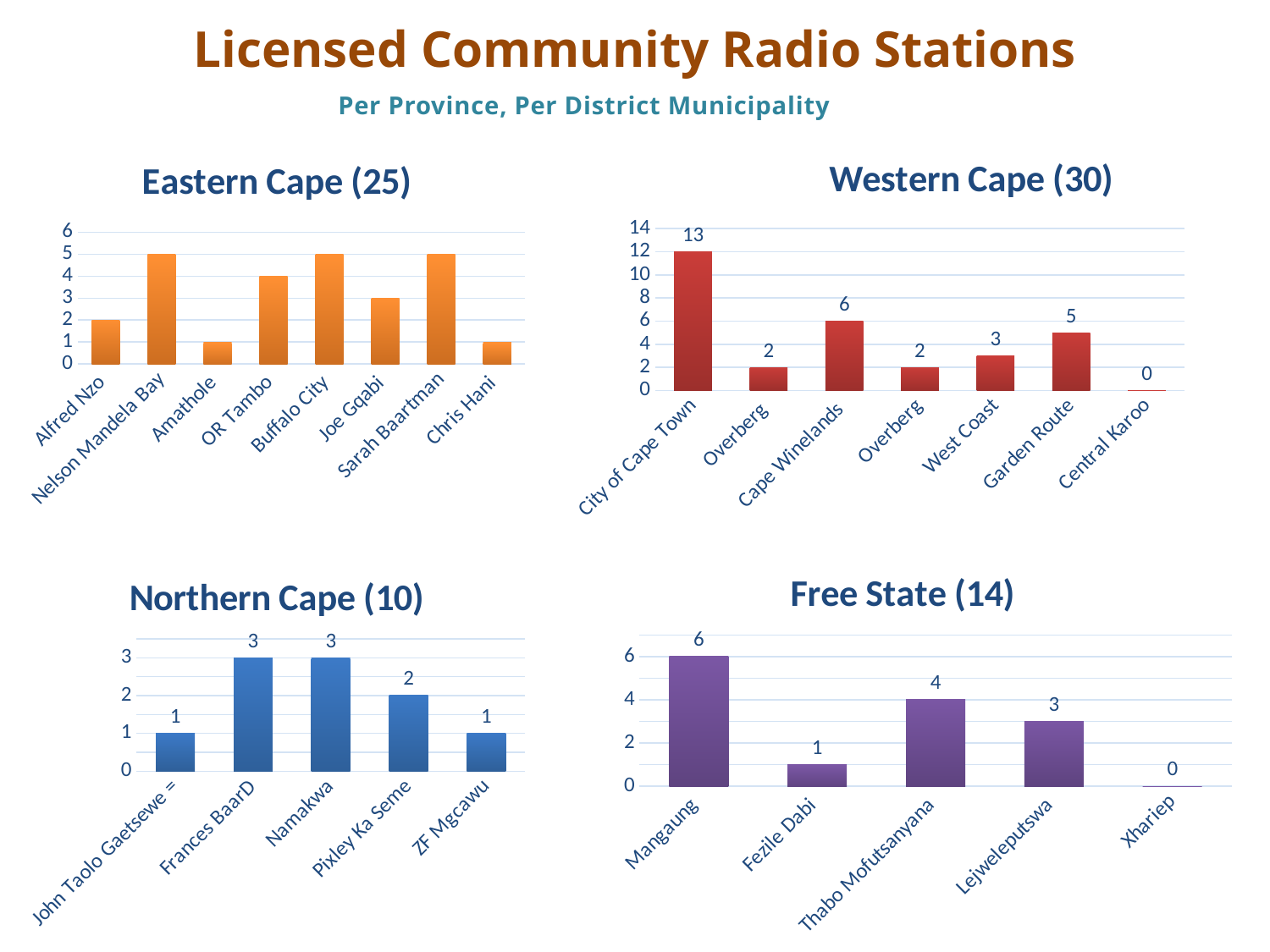
In the Western Cape (30) chart, what is the value for Cape Winelands? 6 In the Northern Cape (10) chart, what is the difference between the values for Frances Baard and Pixley Ka Seme? 1 In the Western Cape (30) chart, which district municipality has the highest value? City of Cape Town In the Eastern Cape (25) chart, what is the value for OR Tambo? 4 In the Free State (14) chart, what is the difference between the values for Mangaung and Lejweleputswa? 3 How many district municipalities are shown in the Eastern Cape (25) chart? 8 In the Free State (14) chart, which district municipality has the lowest value? Xhariep What kind of chart is the Northern Cape (10) chart? Bar chart In the Western Cape (30) chart, which is larger, Garden Route or West Coast? Garden Route How many district municipalities are shown in the Northern Cape (10) chart? 5 In the Western Cape (30) chart, what is the value for Central Karoo? 0 In the Free State (14) chart, what is the value for Thabo Mofutsanyana? 4